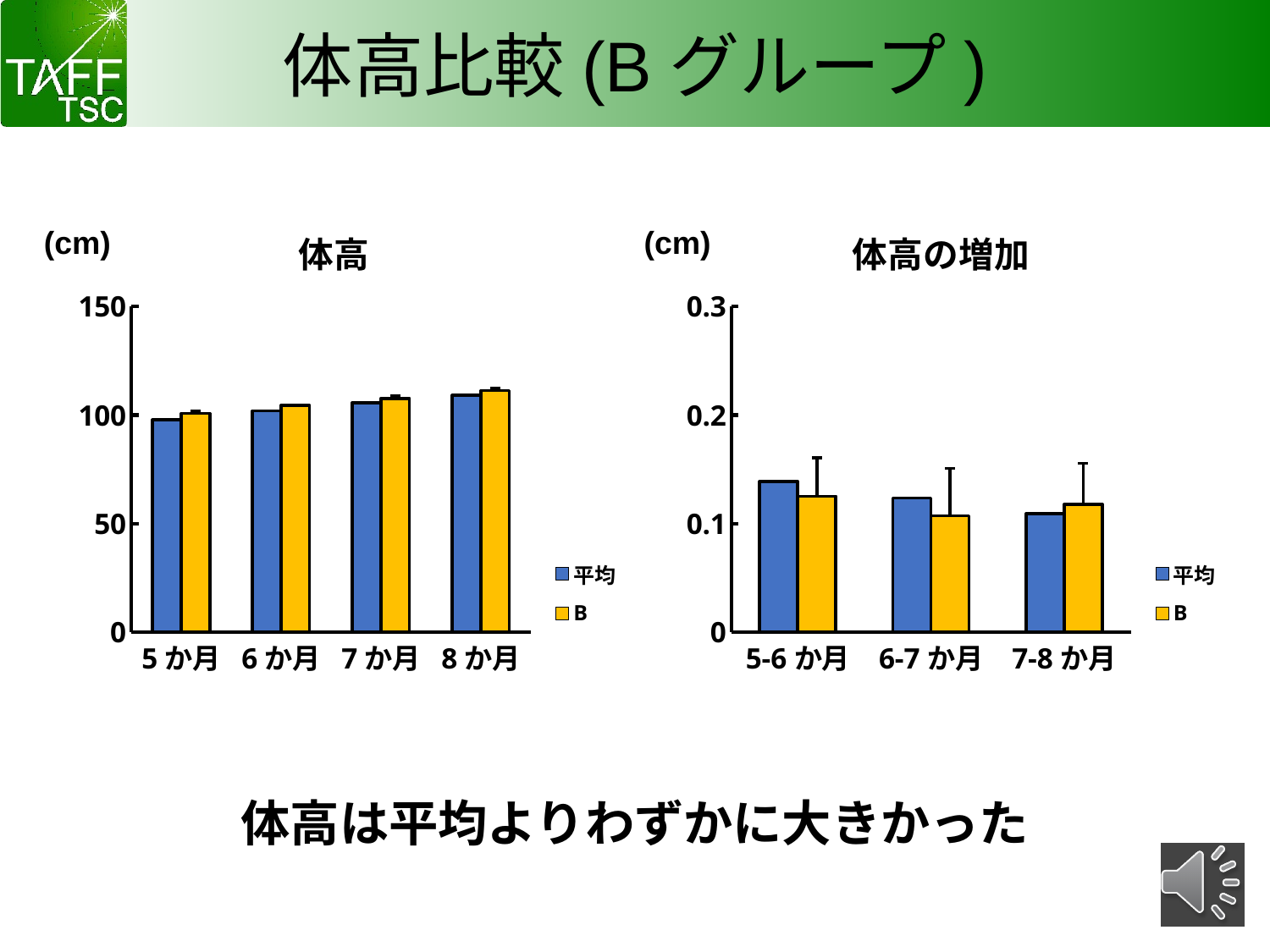
How many categories are shown on the x axis of the right chart (体高の増加)? 3 In the right chart (体高の増加), which category has the highest value for 平均? 5-6 か月 How many categories are shown on the x axis of the left chart (体高)? 4 In the right chart (体高の増加), is the value of B at 5-6 か月 greater or less than 0.2? less In the left chart (体高), which is larger: B at 8 か月 or 平均 at 5 か月? B at 8 か月 How many series does the legend of the right chart (体高の増加) list? 2 In the left chart (体高), is the value of 平均 at 8 か月 greater or less than 150? less In the right chart (体高の増加), do the values of 平均 rise or fall from 5-6 か月 to 7-8 か月? fall In the left chart (体高), is the value of B at 8 か月 greater or less than 100? greater In the left chart (体高), do the values of B rise or fall from 5 か月 to 8 か月? rise What kind of chart is the left chart titled 体高? bar chart